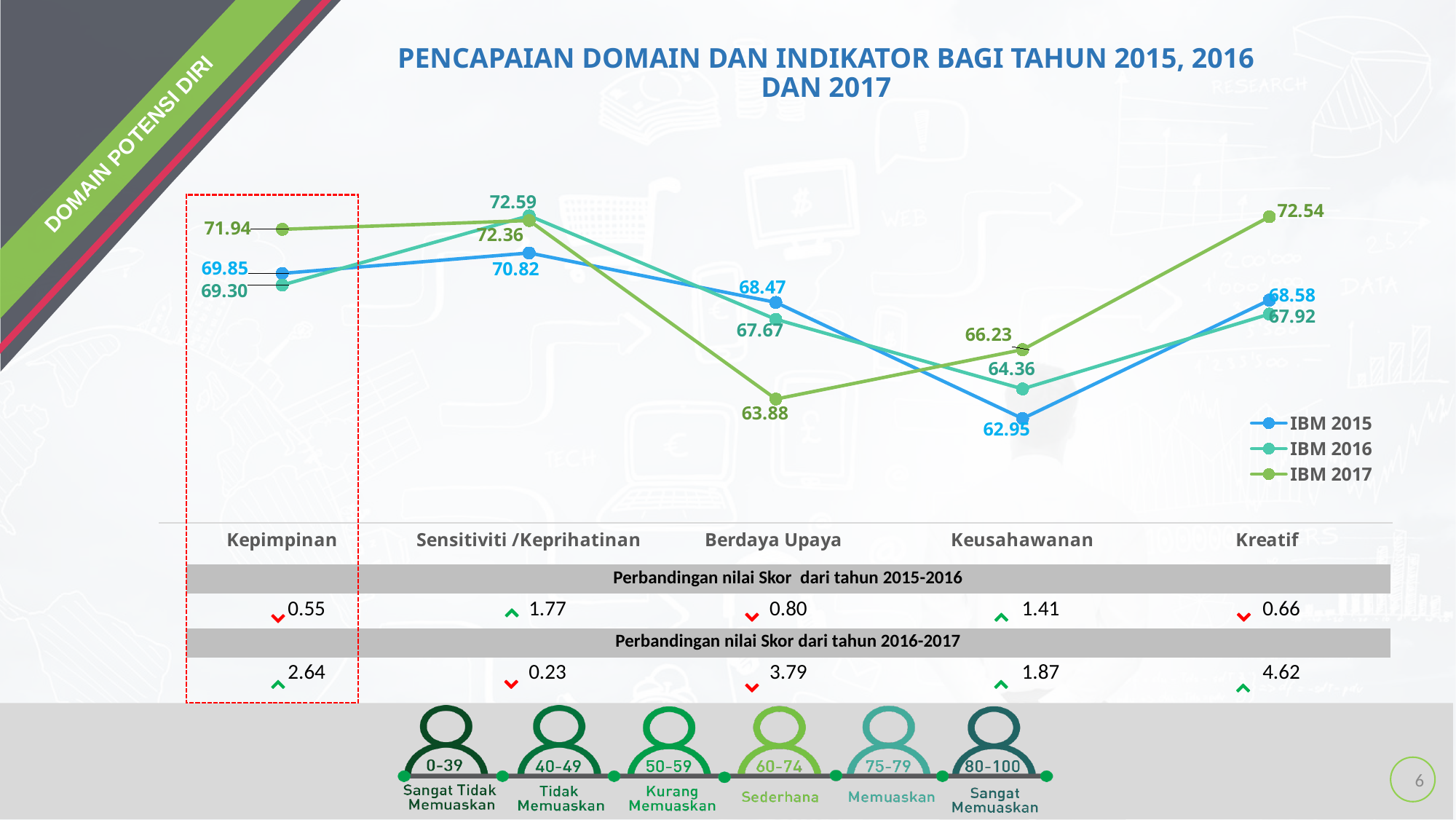
What kind of chart is shown on the slide? Line chart Which category has the lowest IBM 2017 value? Berdaya Upaya How many categories are shown on the x axis of the chart? 5 What is the difference between the IBM 2017 and IBM 2016 values for Kreatif? 4.62 How many series does the chart legend list? 3 What is the IBM 2016 value for Berdaya Upaya? 67.67 What is the IBM 2015 value for Keusahawanan? 62.95 Does the IBM 2015 line rise or fall from Berdaya Upaya to Keusahawanan? Fall Which category has the highest IBM 2016 value? Sensitiviti /Keprihatinan What is the IBM 2017 value for Kreatif? 72.54 Which is larger for Berdaya Upaya: the IBM 2015 value or the IBM 2017 value? IBM 2015 What is the IBM 2017 value for Kepimpinan? 71.94